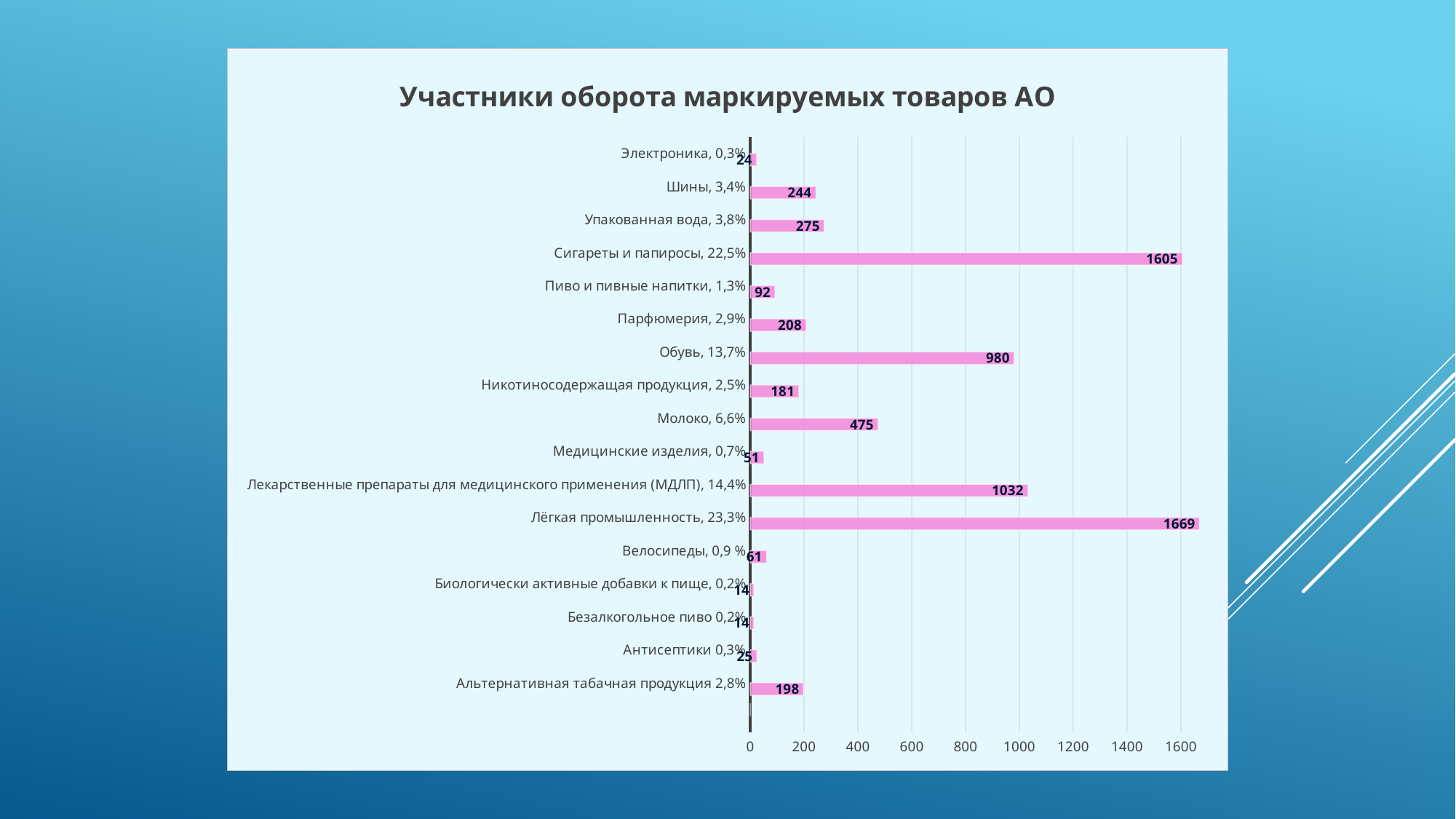
How many categories are shown in the chart? 17 What is the value for Лёгкая промышленность? 1669 What is the value for Обувь? 980 Is the value for Обувь greater or less than 1000? less What is the title of the chart? Участники оборота маркируемых товаров АО Which category has the highest value? Лёгкая промышленность What kind of chart is shown on the slide? bar chart What is the difference between the values for Лёгкая промышленность and Сигареты и папиросы? 64 What is the value for Молоко? 475 What is the difference between the values for Лекарственные препараты для медицинского применения (МДЛП) and Обувь? 52 What is the value for Сигареты и папиросы? 1605 Which is larger, the value for Шины or the value for Упакованная вода? Упакованная вода